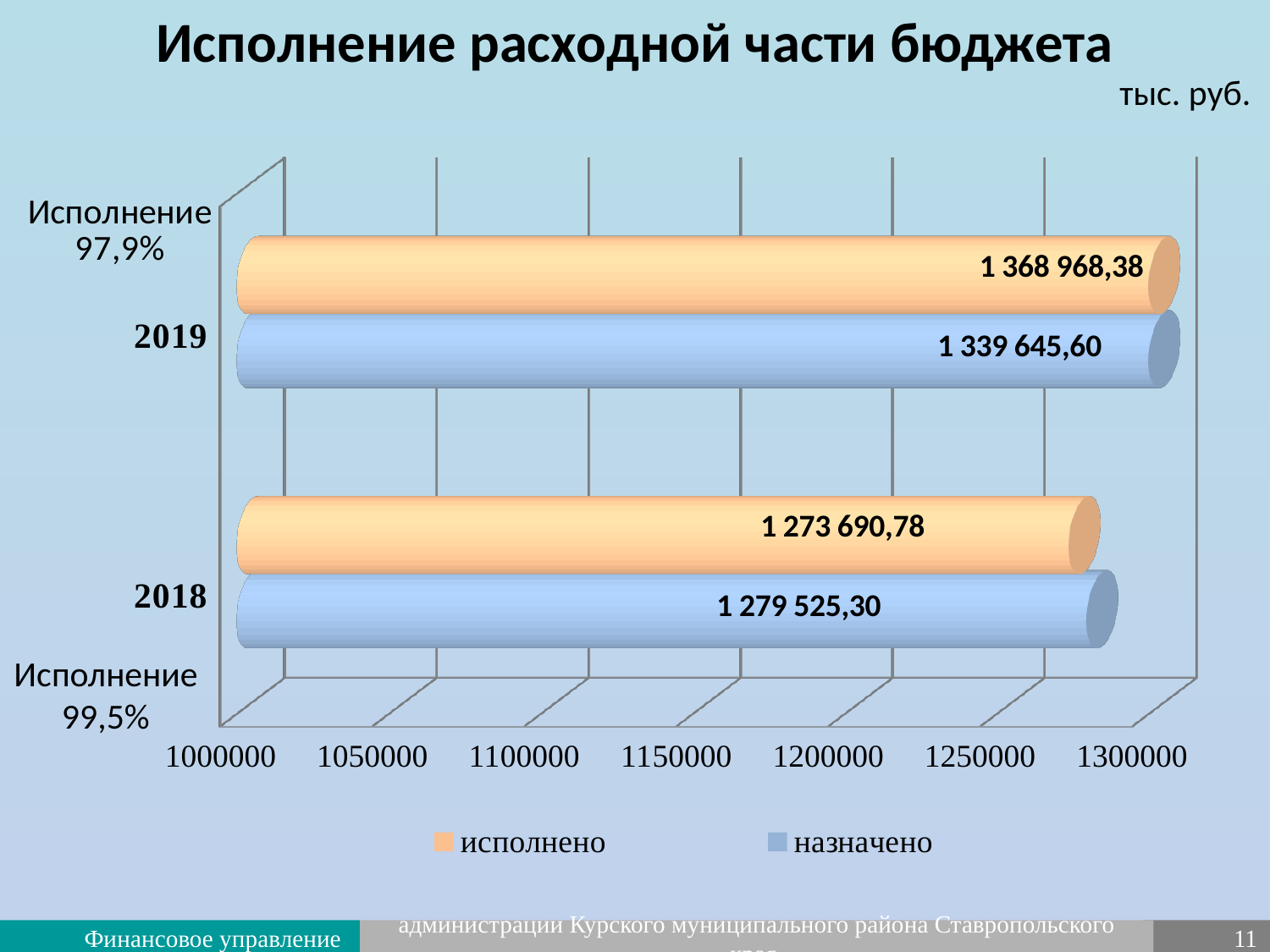
What is the value of the исполнено bar for 2018? 1 273 690,78 How many years (categories) are shown on the chart? 2 What type of chart is shown on the slide? bar chart What is the value of the исполнено bar for 2019? 1 368 968,38 For 2018, which is larger: исполнено or назначено? назначено What is the value of the назначено bar for 2018? 1 279 525,30 Is the исполнено value for 2018 greater or less than 1250000? greater What is the value of the назначено bar for 2019? 1 339 645,60 How many series does the legend list? 2 What unit of measurement is indicated for the chart values? тыс. руб. Which bar has the highest value on the chart? исполнено for 2019 What is the difference between the исполнено and назначено values for 2019? 29 322,78